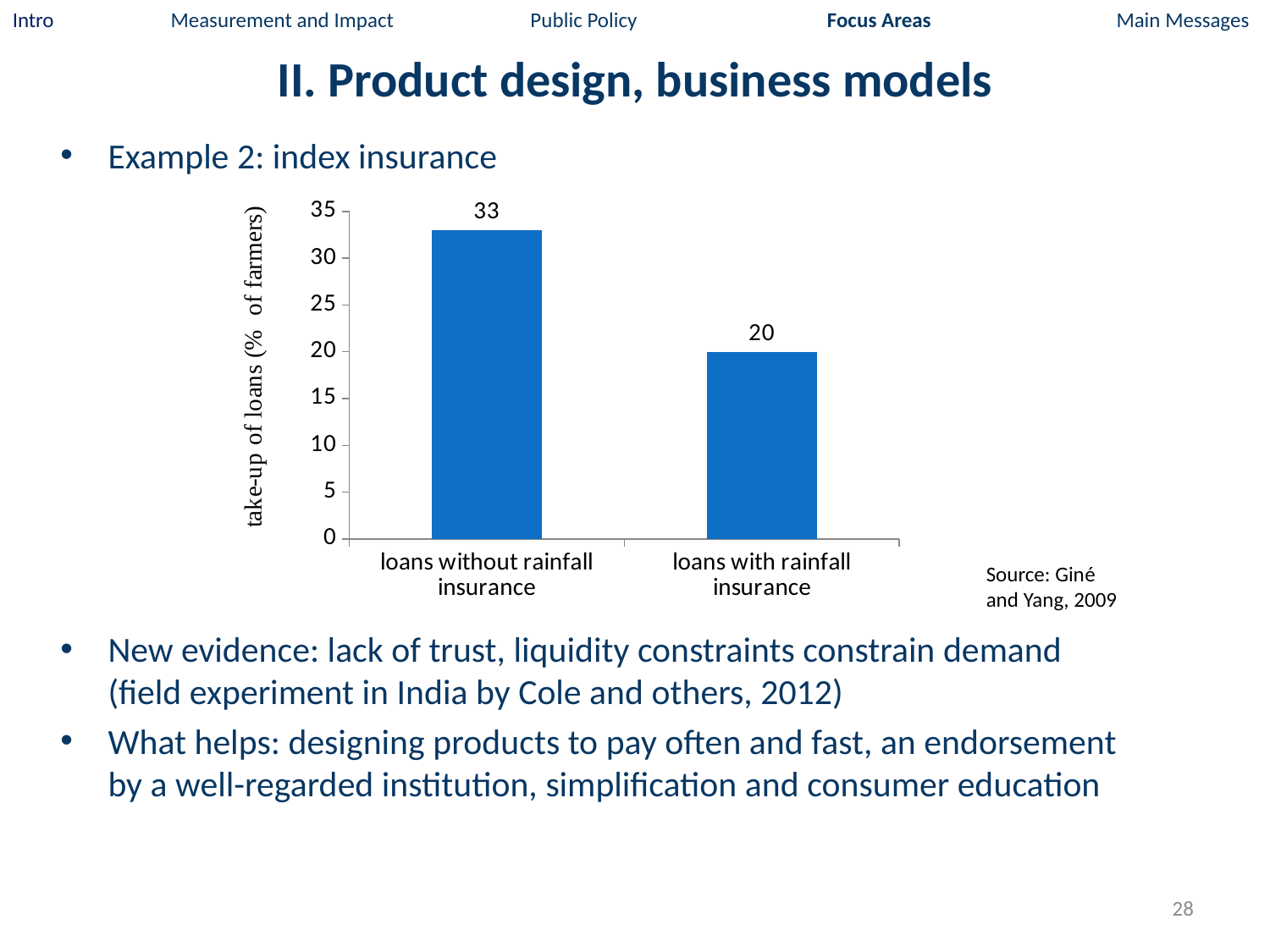
Is the take-up of loans higher for loans with rainfall insurance or for loans without rainfall insurance? loans without rainfall insurance What is the take-up of loans for loans with rainfall insurance? 20 What source is cited for the chart? Giné and Yang, 2009 What is the difference in take-up of loans between loans without rainfall insurance and loans with rainfall insurance? 13 What kind of chart is shown on the slide? bar chart What is the label of the vertical axis of the chart? take-up of loans (% of farmers) What is the take-up of loans for loans without rainfall insurance? 33 Which category has the lower take-up of loans? loans with rainfall insurance Is the value for loans with rainfall insurance greater or less than 25? less Is the value for loans without rainfall insurance greater or less than 30? greater Which category has the higher take-up of loans? loans without rainfall insurance How many categories are shown on the chart? 2